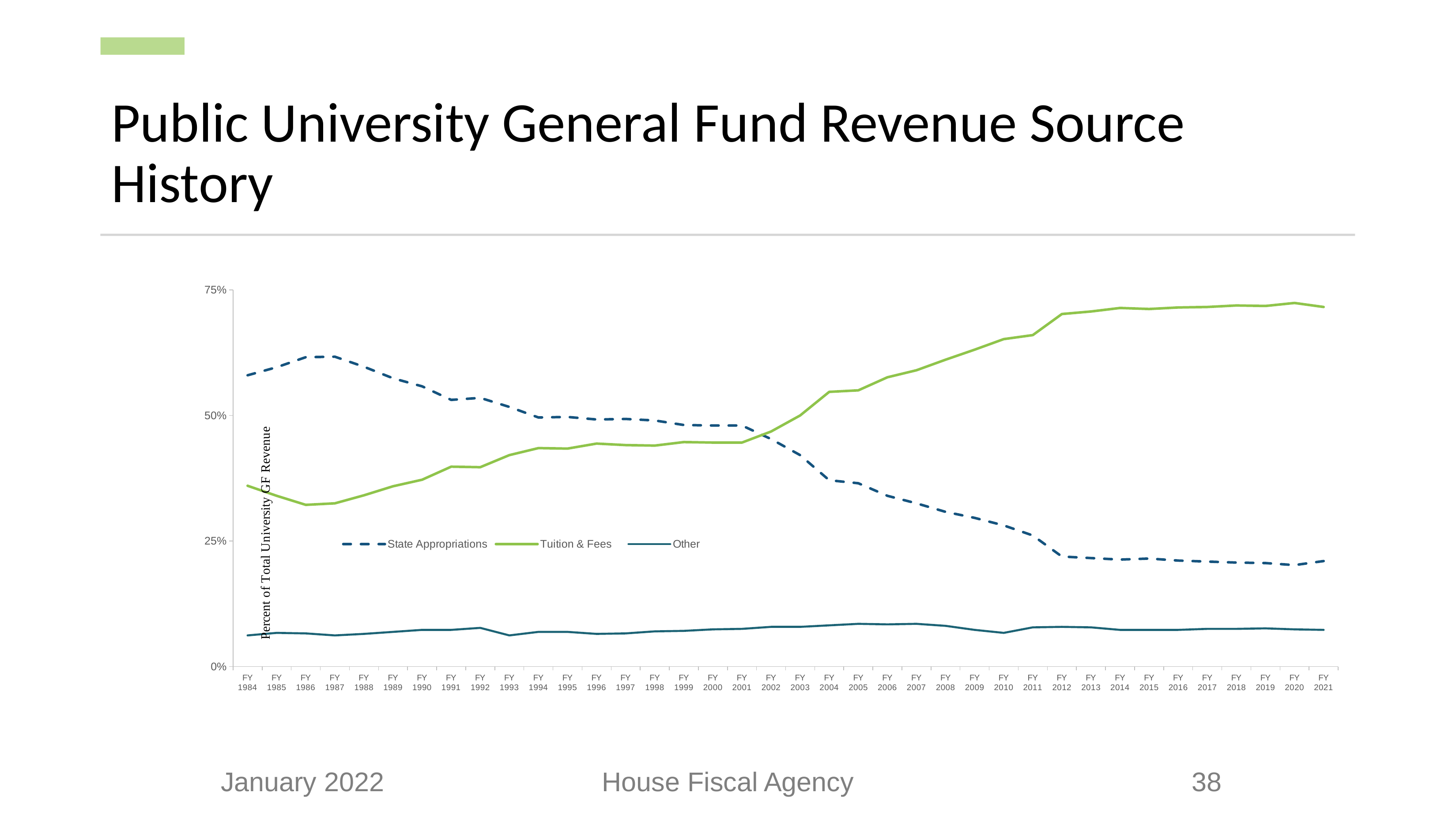
How many fiscal years are plotted along the x axis? 38 Is the value for Tuition & Fees in FY 2021 greater or less than 50%? greater Is the value for State Appropriations in FY 2021 greater or less than 25%? less In FY 2021, which is larger: Tuition & Fees or State Appropriations? Tuition & Fees What kind of chart is shown on the slide? line chart In FY 1984, which is larger: State Appropriations or Tuition & Fees? State Appropriations Is the value for State Appropriations in FY 1984 greater or less than 50%? greater Does the State Appropriations line rise or fall from FY 1984 to FY 2021? fall Which series has the lowest values across all years shown? Other Does the Tuition & Fees line rise or fall from FY 1984 to FY 2021? rise How many series does the legend list? 3 What is the title of the vertical axis? Percent of Total University GF Revenue